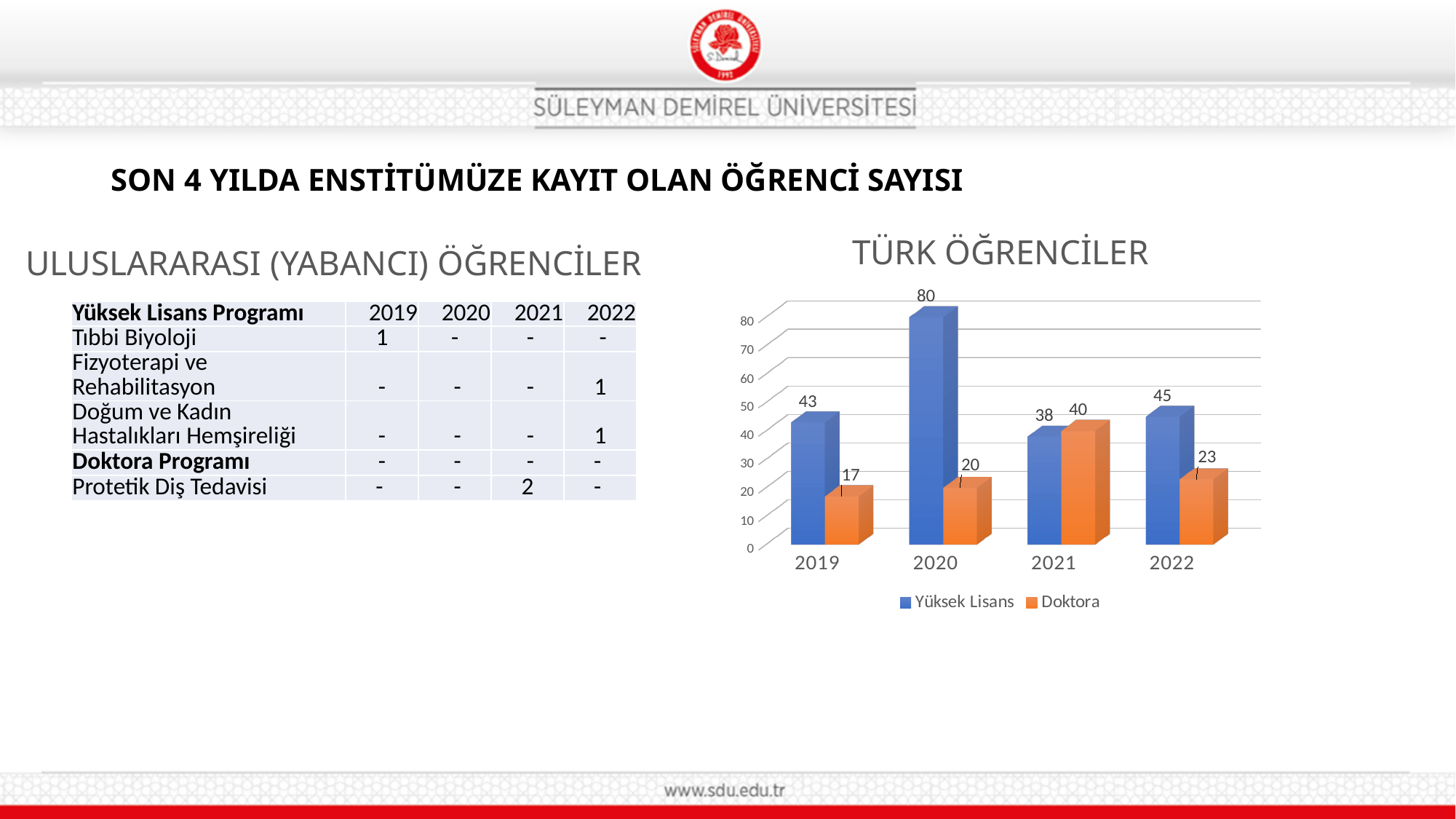
In the TÜRK ÖĞRENCİLER chart, which colour represents the Doktora series? Orange In the TÜRK ÖĞRENCİLER chart, which year has the lowest Doktora value? 2019 In the TÜRK ÖĞRENCİLER chart, which year has the highest Yüksek Lisans value? 2020 In the TÜRK ÖĞRENCİLER chart, what is the Doktora value for 2021? 40 In the TÜRK ÖĞRENCİLER chart, how many years are shown on the x axis? 4 In the TÜRK ÖĞRENCİLER chart, what is the difference between the Yüksek Lisans values for 2022 and 2021? 7 In the TÜRK ÖĞRENCİLER chart, what is the Yüksek Lisans value for 2020? 80 In the TÜRK ÖĞRENCİLER chart, what is the difference between the Yüksek Lisans and Doktora values in 2020? 60 In the TÜRK ÖĞRENCİLER chart, how many series does the legend list? 2 In the TÜRK ÖĞRENCİLER chart, which is larger in 2021: Yüksek Lisans or Doktora? Doktora In the TÜRK ÖĞRENCİLER chart, what is the Doktora value for 2019? 17 What kind of chart is the TÜRK ÖĞRENCİLER chart? Bar chart